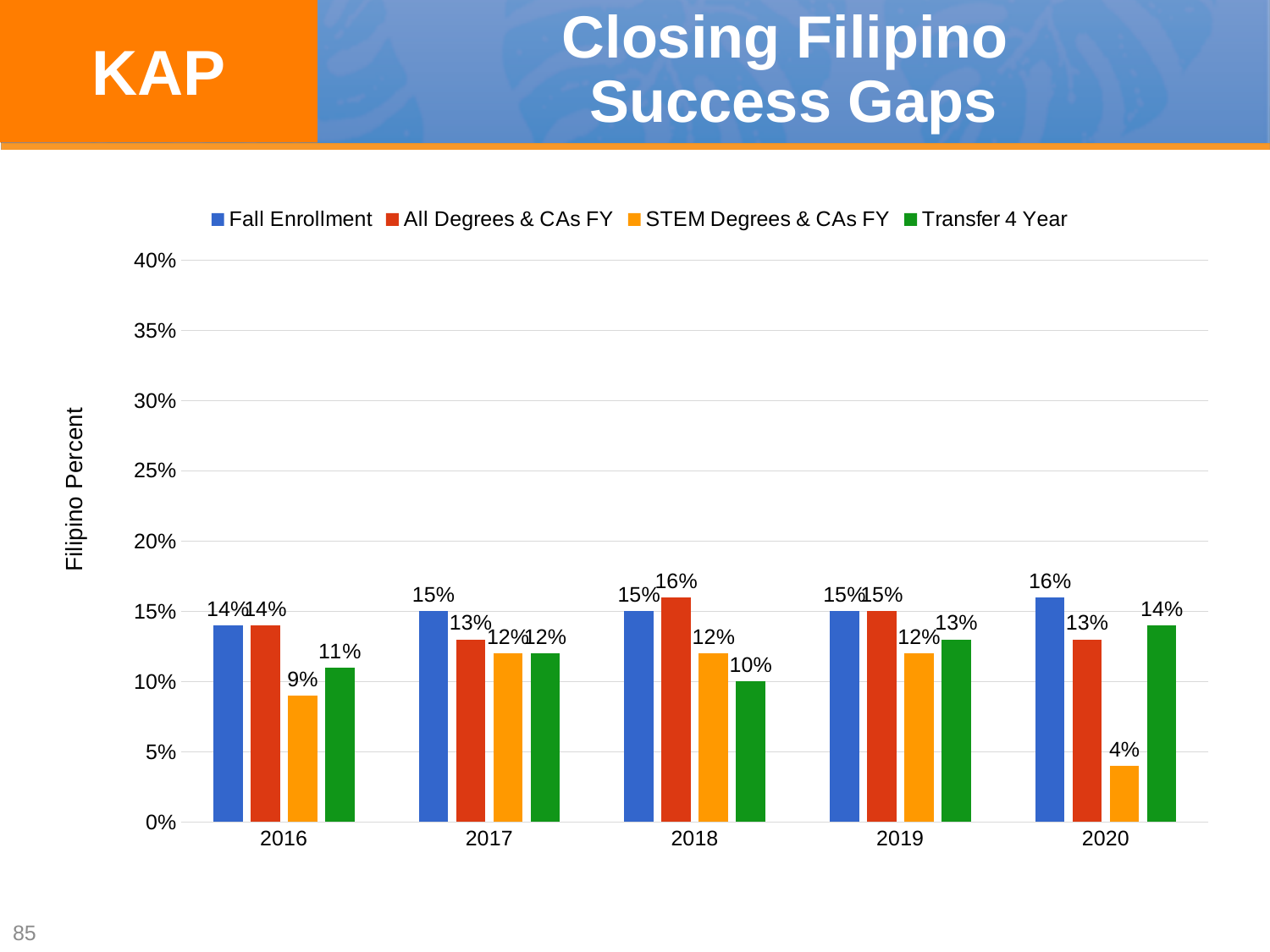
Which is larger in 2017: All Degrees & CAs FY or Transfer 4 Year? All Degrees & CAs FY Which series has the highest value in 2018? All Degrees & CAs FY What is the difference between the Fall Enrollment and STEM Degrees & CAs FY values in 2020? 12% In which year is the STEM Degrees & CAs FY value lowest? 2020 How many years are shown on the x axis? 5 How many series does the legend list? 4 What kind of chart is shown on the slide? Bar chart What is the STEM Degrees & CAs FY value for 2020? 4% What is the Transfer 4 Year value for 2016? 11% What is the label on the vertical axis? Filipino Percent What is the All Degrees & CAs FY value for 2018? 16% What is the Fall Enrollment value for 2020? 16%